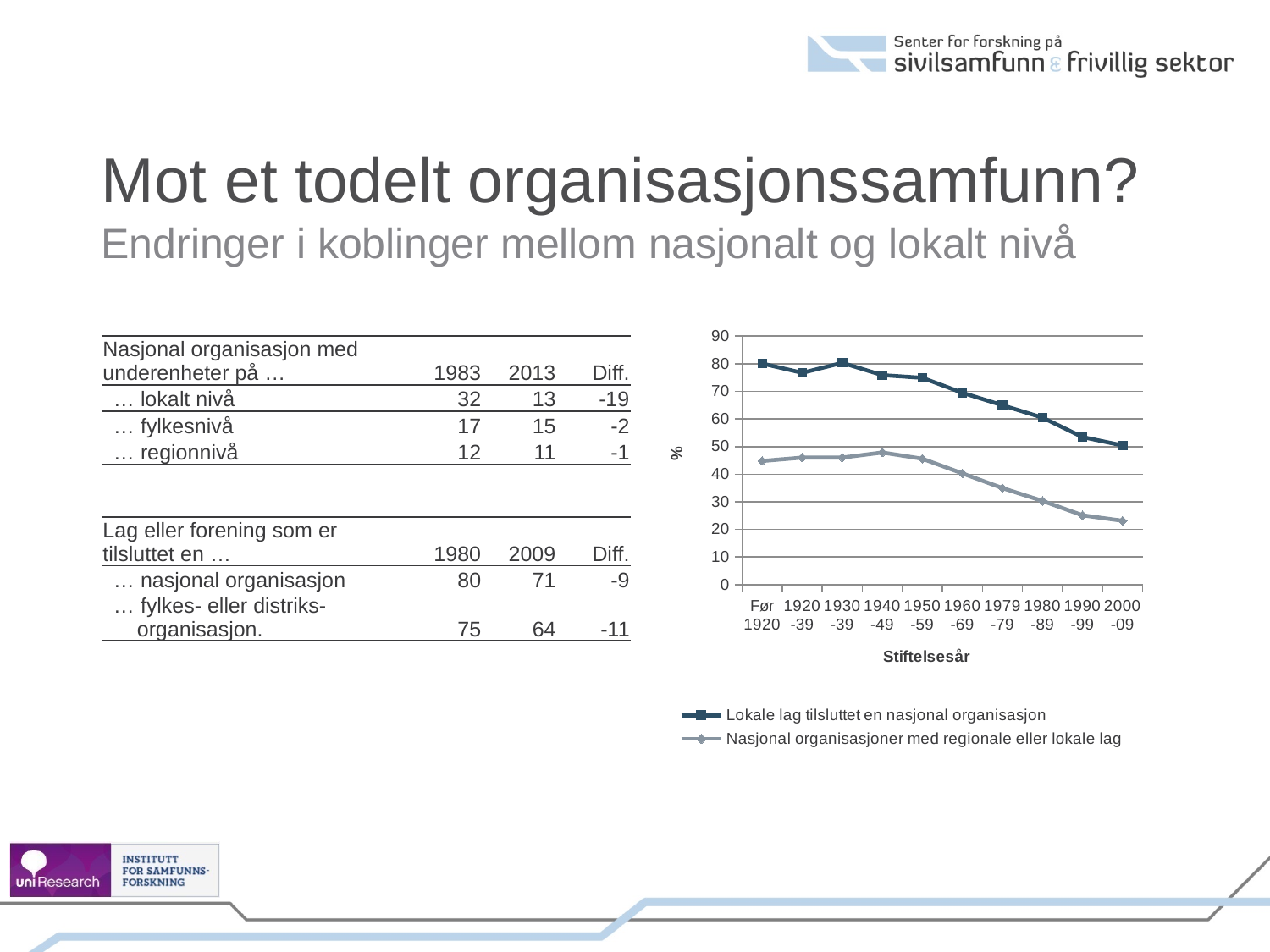
Is the value for 'Nasjonal organisasjoner med regionale eller lokale lag' at '2000-09' greater or less than 30? less How many series does the chart legend list? 2 Is the value for 'Nasjonal organisasjoner med regionale eller lokale lag' at '1940-49' greater or less than 50? less At '1950-59', which series has the larger value: 'Lokale lag tilsluttet nasjonal organisasjon' or 'Nasjonal organisasjoner med regionale eller lokale lag'? Lokale lag tilsluttet nasjonal organisasjon Is the value for 'Lokale lag tilsluttet nasjonal organisasjon' at '2000-09' greater or less than 60? less How many founding-year (Stiftelsesår) categories are shown on the x axis of the chart? 10 Which founding-year category has the lowest value for 'Lokale lag tilsluttet nasjonal organisasjon'? 2000-09 What kind of chart is shown on the slide? line chart Do the values for 'Lokale lag tilsluttet nasjonal organisasjon' generally rise or fall from 'Før 1920' to '2000-09'? fall Which founding-year category has the lowest value for 'Nasjonal organisasjoner med regionale eller lokale lag'? 2000-09